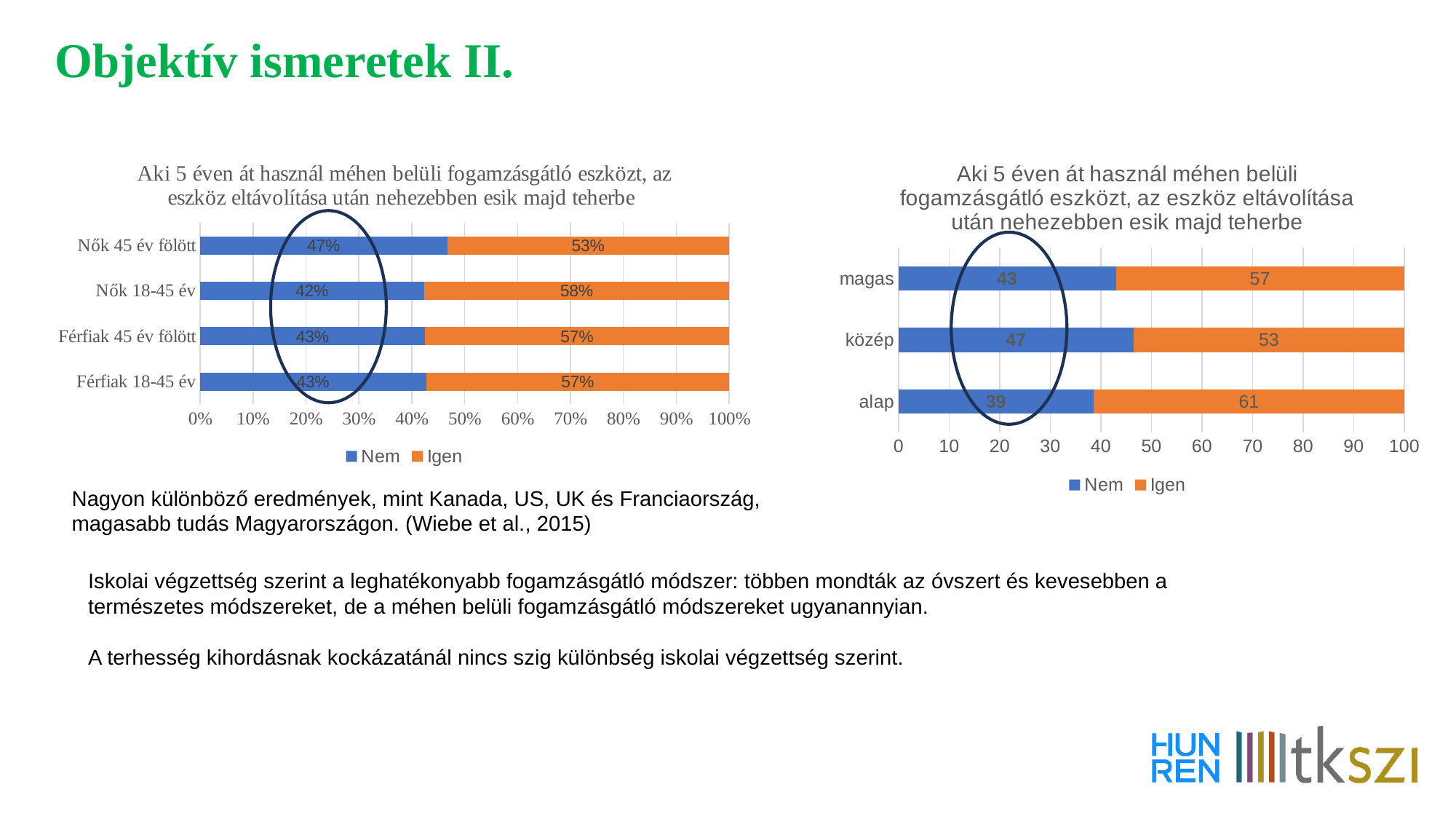
In the left chart, what is the 'Nem' value for 'Nők 45 év fölött'? 47% In the left chart, how many categories are shown? 4 In the right chart, what is the 'Nem' value for 'alap'? 39 What type of chart is the right chart? Stacked bar chart In the right chart, what is the difference between the 'Nem' values for 'közép' and 'alap'? 8 In the left chart, which category has the highest 'Nem' value? Nők 45 év fölött In the left chart, what is the difference between the 'Igen' and 'Nem' values for 'Férfiak 45 év fölött'? 14% In the right chart, which category has the highest 'Igen' value? alap In the left chart, which category has the lowest 'Nem' value? Nők 18-45 év In the left chart, what is the 'Igen' value for 'Nők 18-45 év'? 58% In the right chart, how many series does the legend list? 2 In the right chart, what is the 'Igen' value for 'magas'? 57